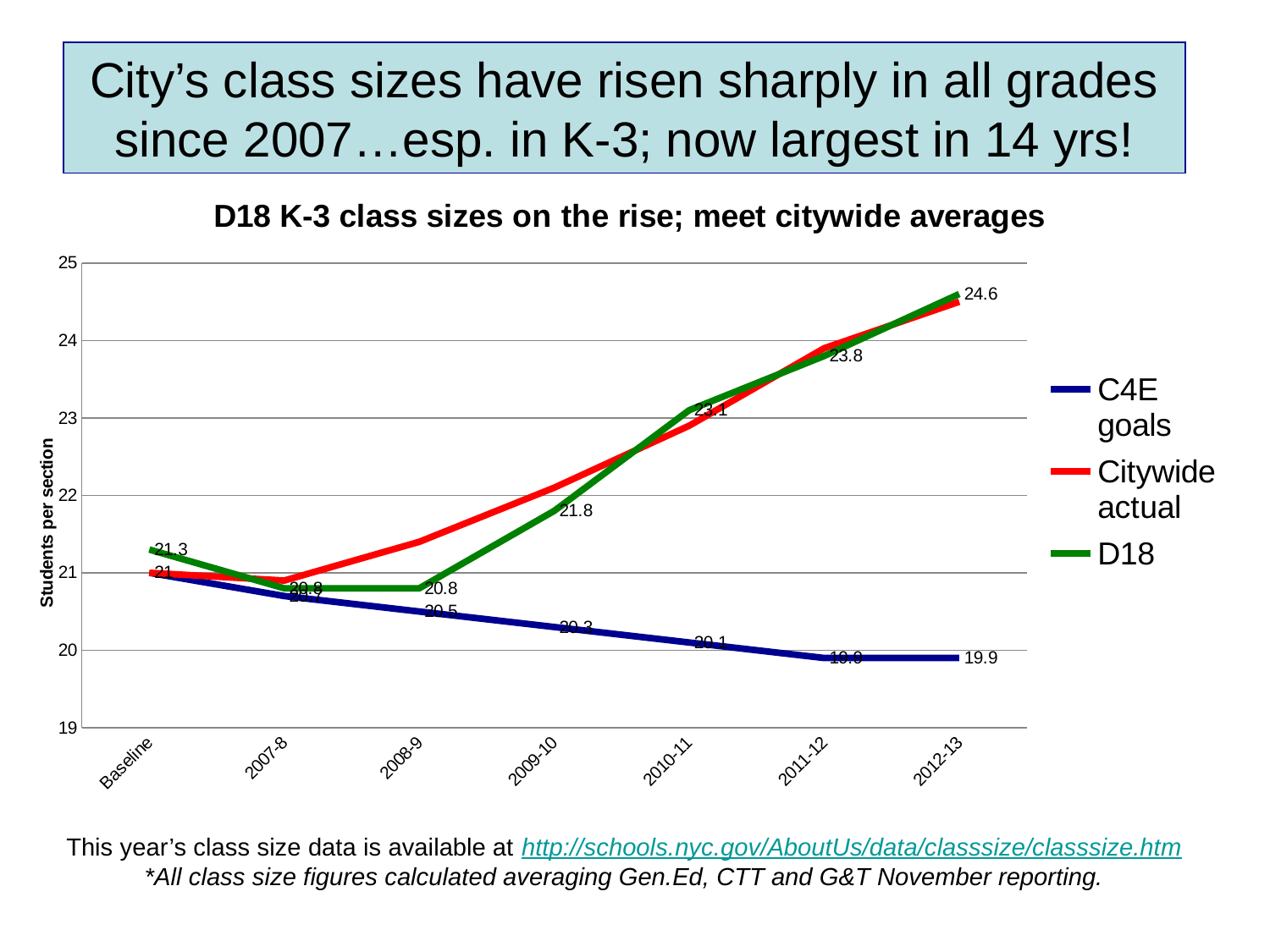
What is the C4E goals value for 2008-9? 20.5 What is the D18 value for 2009-10? 21.8 By how much does the D18 value in 2012-13 exceed the C4E goals value in 2012-13? 4.7 What is the D18 value for 2012-13? 24.6 What type of chart is shown on the slide? line chart How many series does the legend list? 3 Do the C4E goals values rise or fall from Baseline to 2012-13? fall How many points are plotted along the x axis for each series? 7 What is the D18 value at Baseline? 21.3 What is the C4E goals value for 2012-13? 19.9 Is the Citywide actual value for 2012-13 greater or less than 24? greater In which year does the D18 series reach its highest value? 2012-13